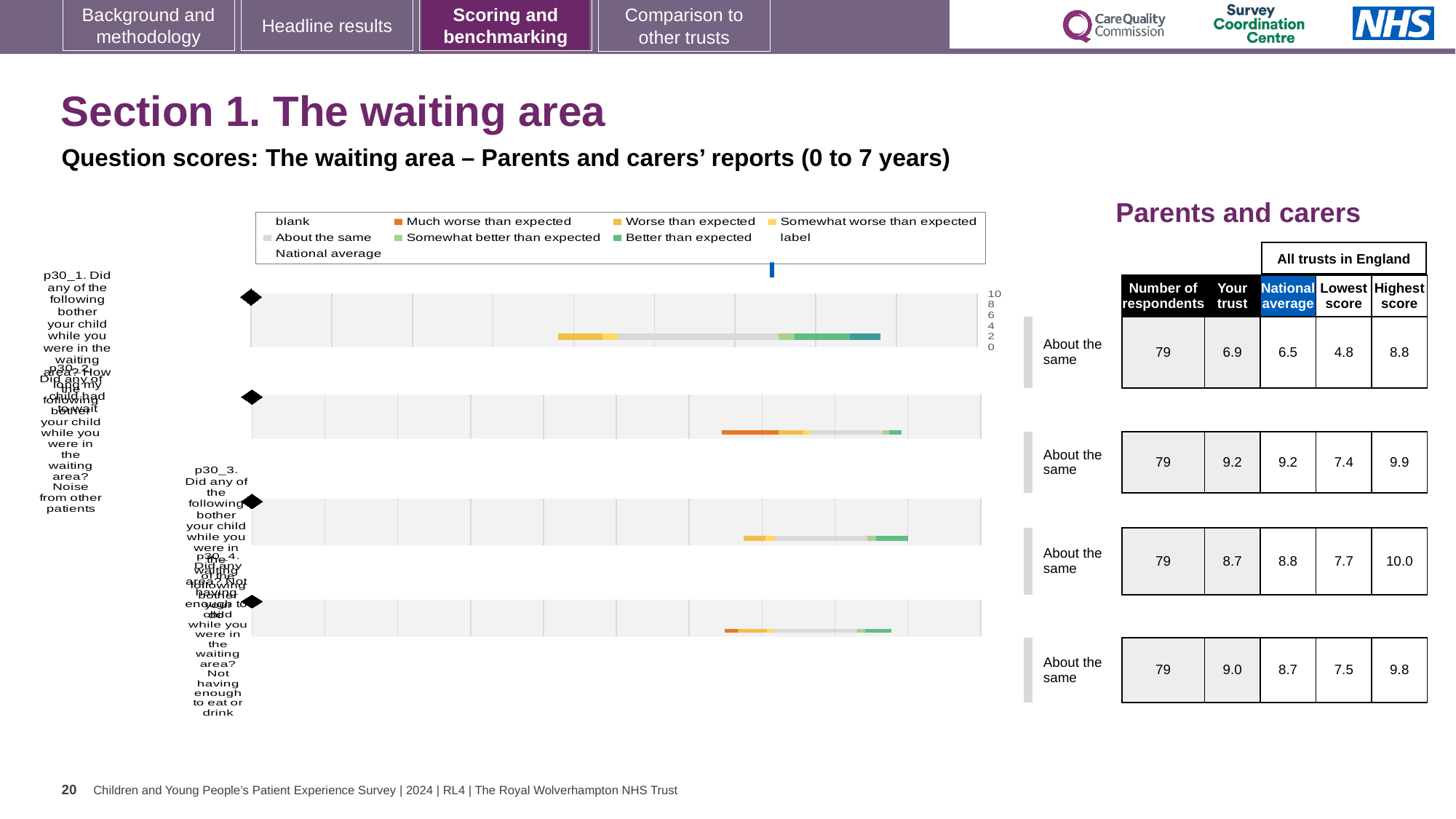
What is the highest score across all trusts in England for the third question (p30_3)? 10.0 What is the difference between the highest and lowest 'Your trust' scores in the table? 2.3 What is the 'Your trust' score for the first question (p30_1) in the table beside the chart? 6.9 How many entries does the chart legend list? 9 Which legend entry is shown in orange? Much worse than expected How many question bars are plotted in the chart? 4 What is the national average for the second question (p30_2) in the table beside the chart? 9.2 What kind of chart is shown on the slide? bar chart Which question has the lowest 'Your trust' score in the table? p30_1 For the fourth question (p30_4), which is larger: the 'Your trust' score or the national average? Your trust How many respondents are listed for the fourth question (p30_4)? 79 Which question has the highest 'Your trust' score in the table? p30_2